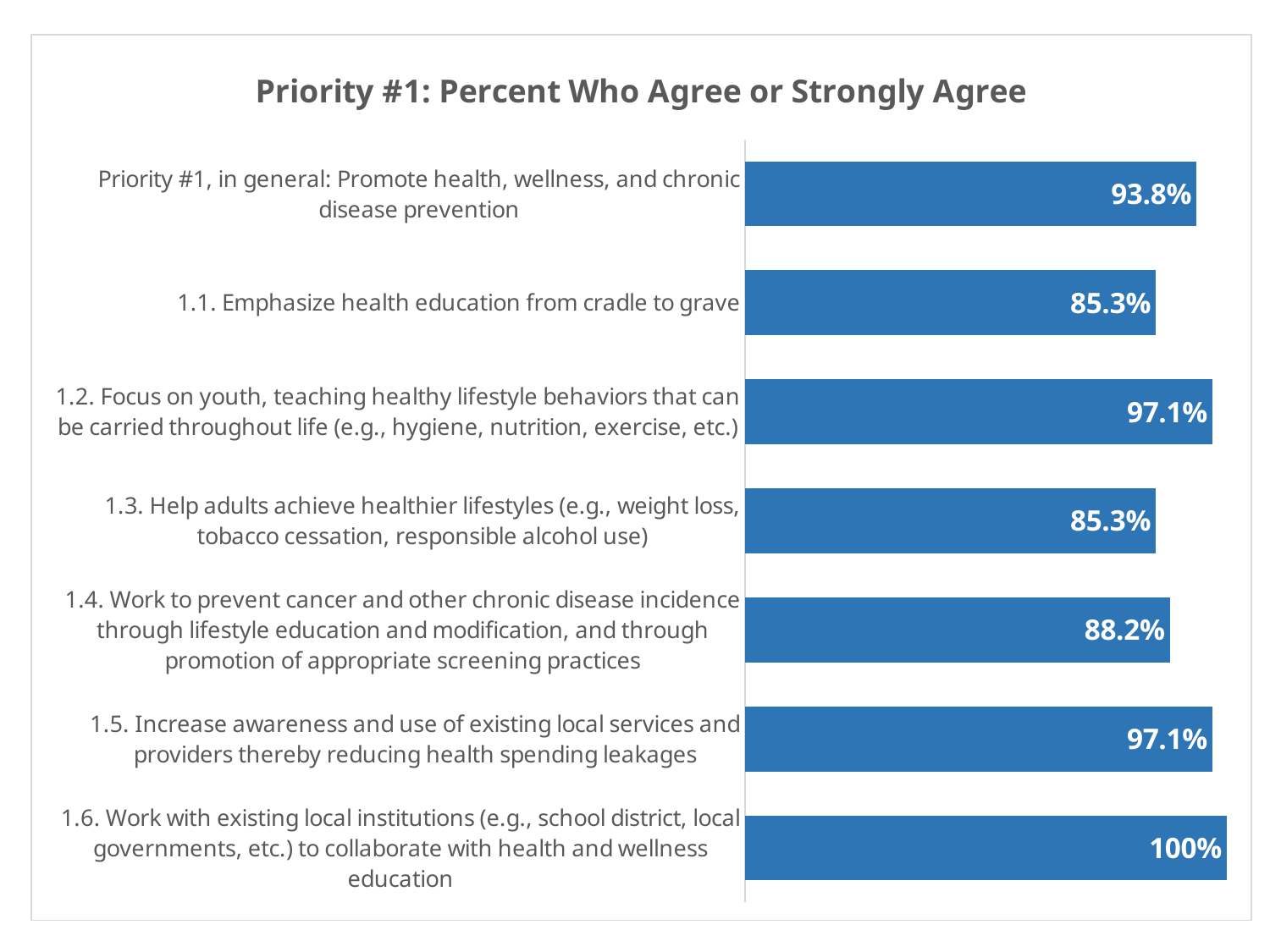
What is the highest value shown on the chart? 100% What is the lowest value shown on the chart? 85.3% What is the value for Priority #1, in general: Promote health, wellness, and chronic disease prevention? 93.8% What kind of chart is shown on the slide? Bar chart Which category has the highest percent who agree or strongly agree? 1.6. Work with existing local institutions (e.g., school district, local governments, etc.) to collaborate with health and wellness education Which is larger: the value for Priority #1, in general or the value for 1.3. Help adults achieve healthier lifestyles? Priority #1, in general What percent agree or strongly agree with 1.1. Emphasize health education from cradle to grave? 85.3% What is the difference between the value for 1.2 (Focus on youth) and the value for 1.4 (Work to prevent cancer and other chronic disease incidence)? 8.9% What is the value for 1.5. Increase awareness and use of existing local services and providers thereby reducing health spending leakages? 97.1% How many categories are shown on the chart? 7 What is the difference between the value for 1.6 (Work with existing local institutions) and the value for 1.1 (Emphasize health education from cradle to grave)? 14.7% What is the value for 1.4. Work to prevent cancer and other chronic disease incidence through lifestyle education and modification, and through promotion of appropriate screening practices? 88.2%